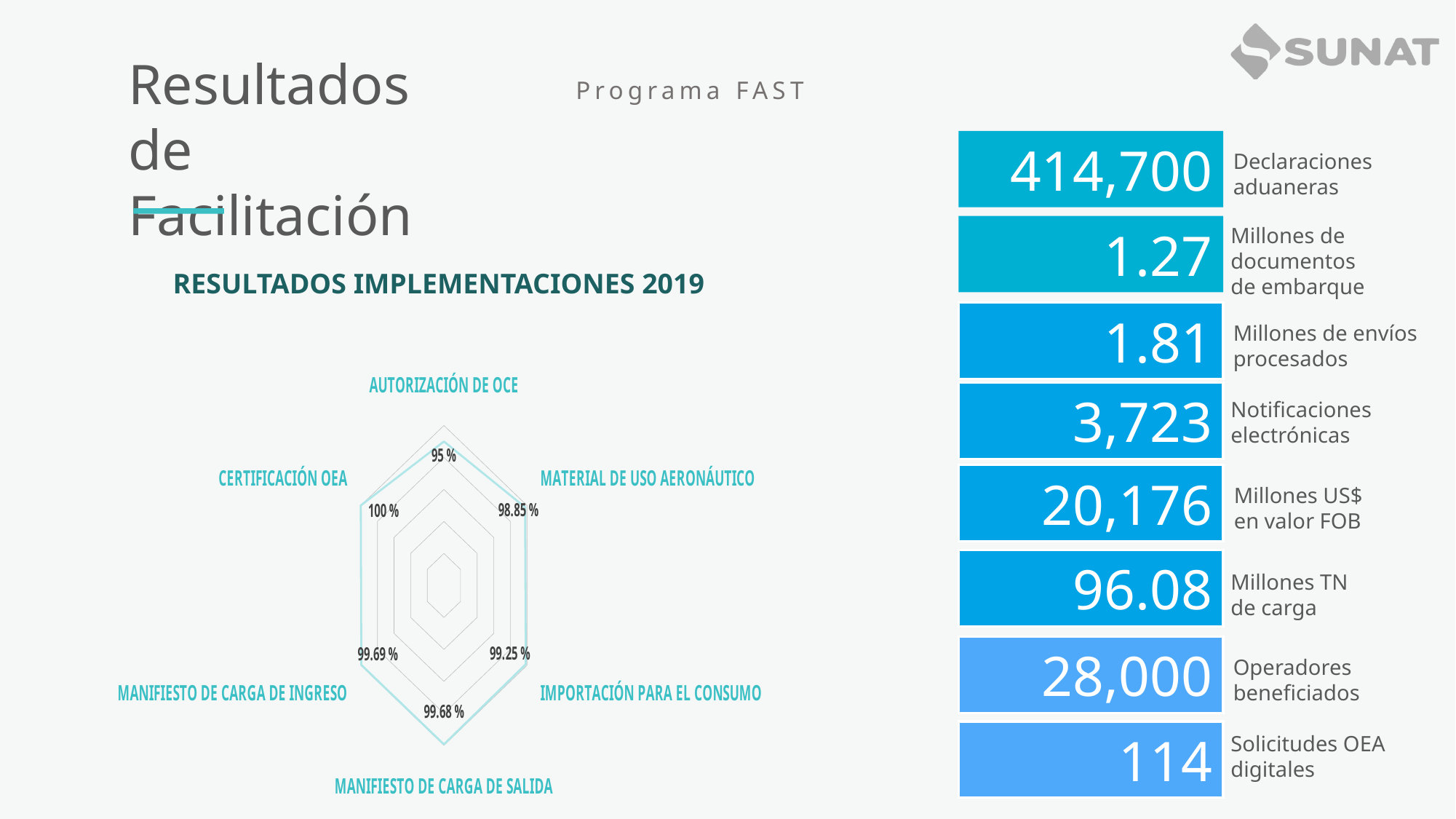
What value is shown for Certificación OEA on the radar chart? 100 % What is the difference between the values for Certificación OEA and Autorización de OCE on the radar chart? 5 % How many categories are plotted on the radar chart? 6 What value is shown for Importación para el consumo on the radar chart? 99.25 % What value is shown for Autorización de OCE on the radar chart? 95 % What value is shown for Manifiesto de carga de ingreso on the radar chart? 99.69 % What value is shown for Manifiesto de carga de salida on the radar chart? 99.68 % Which category has the lowest value on the radar chart? Autorización de OCE What type of chart is shown on the slide? Radar chart Which category has the highest value on the radar chart? Certificación OEA Which has a larger value on the radar chart, Material de uso aeronáutico or Importación para el consumo? Importación para el consumo What value is shown for Material de uso aeronáutico on the radar chart? 98.85 %